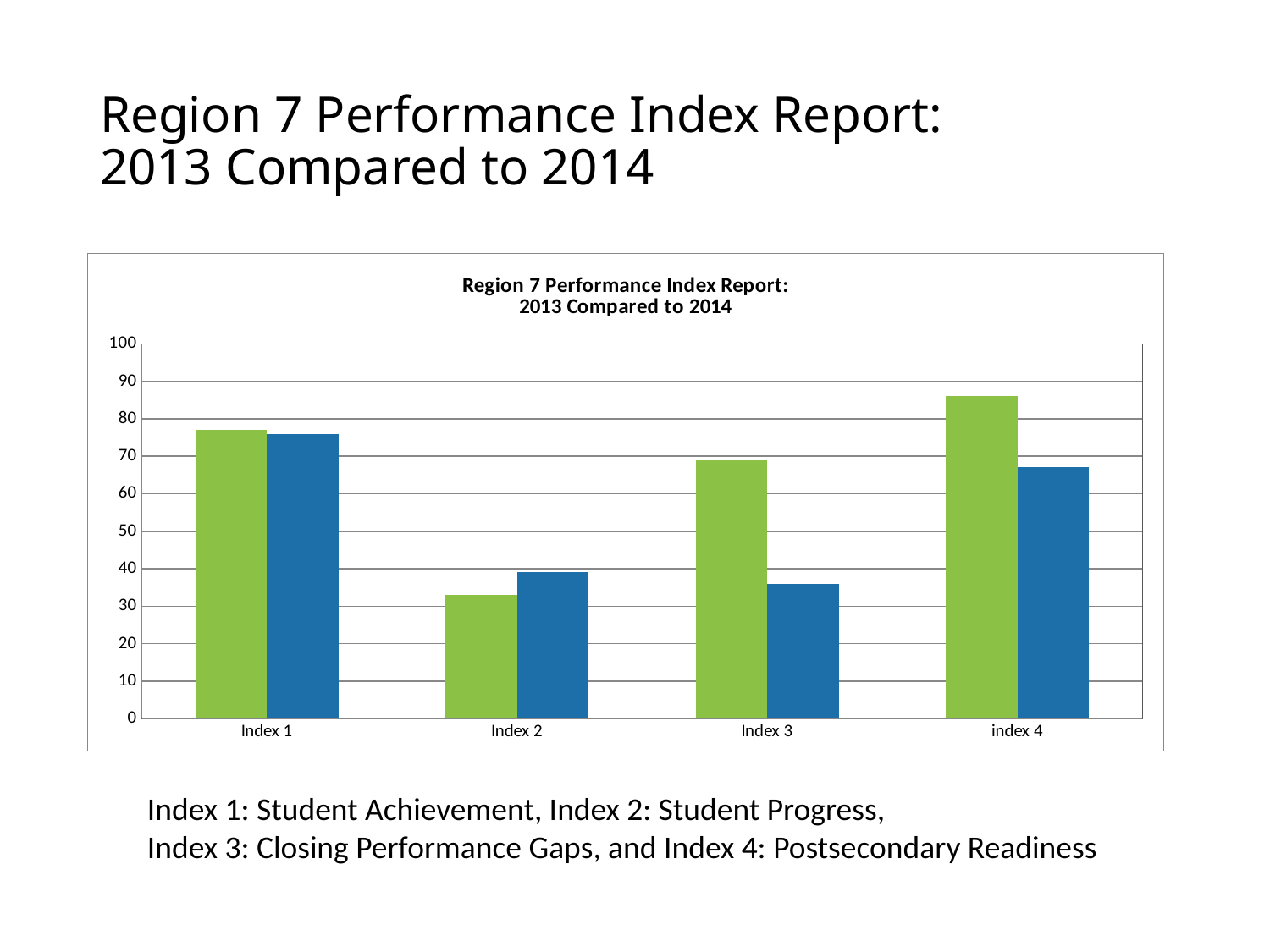
What kind of chart is shown on the slide? bar chart Is the green bar for Index 2 greater or less than 40? less Which category has the tallest green bar? index 4 For Index 2, which bar is taller, the green bar or the blue bar? blue Which category has the shortest blue bar? Index 3 For Index 3, which bar is taller, the green bar or the blue bar? green Is the blue bar for Index 3 greater or less than 40? less How many categories are shown on the x axis of the chart? 4 What is the title of the chart? Region 7 Performance Index Report: 2013 Compared to 2014 Which category has the shortest green bar? Index 2 Is the green bar for index 4 greater or less than 80? greater Which category has the tallest blue bar? Index 1